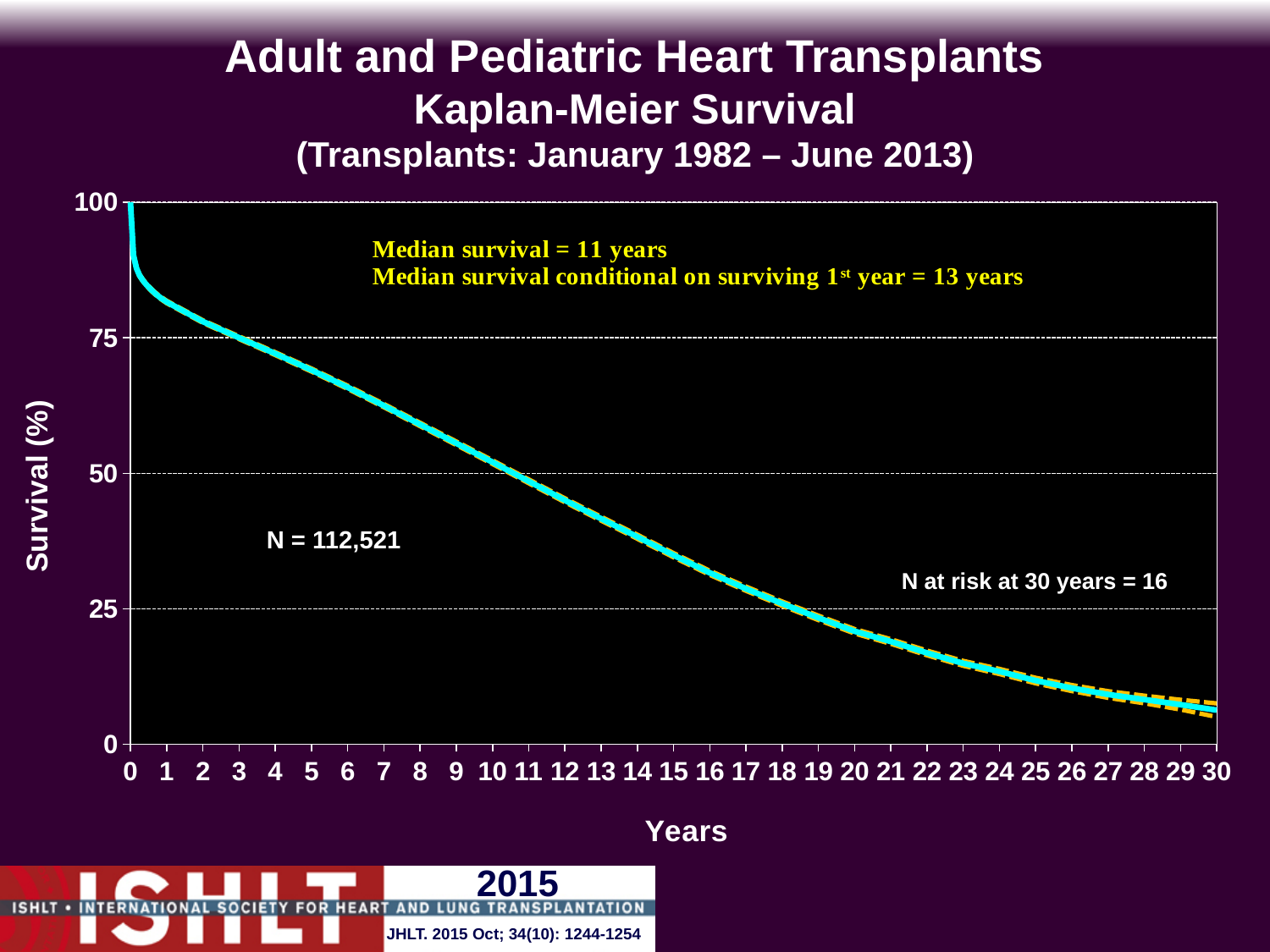
Is the survival value at 20 years greater or less than 25? less Is the survival value at 15 years greater or less than 25? greater What is the median survival conditional on surviving the 1st year, as printed on the chart? 13 years What is the median survival printed on the chart? 11 years Is the survival value at 5 years greater or less than 50? greater What kind of chart is shown on the slide? line chart Does the survival curve rise or fall as years increase? fall What is the N at risk at 30 years printed on the chart? 16 What is the value of N printed on the chart? 112,521 What is the title of the chart? Adult and Pediatric Heart Transplants Kaplan-Meier Survival (Transplants: January 1982 – June 2013) What is the label of the y axis? Survival (%)